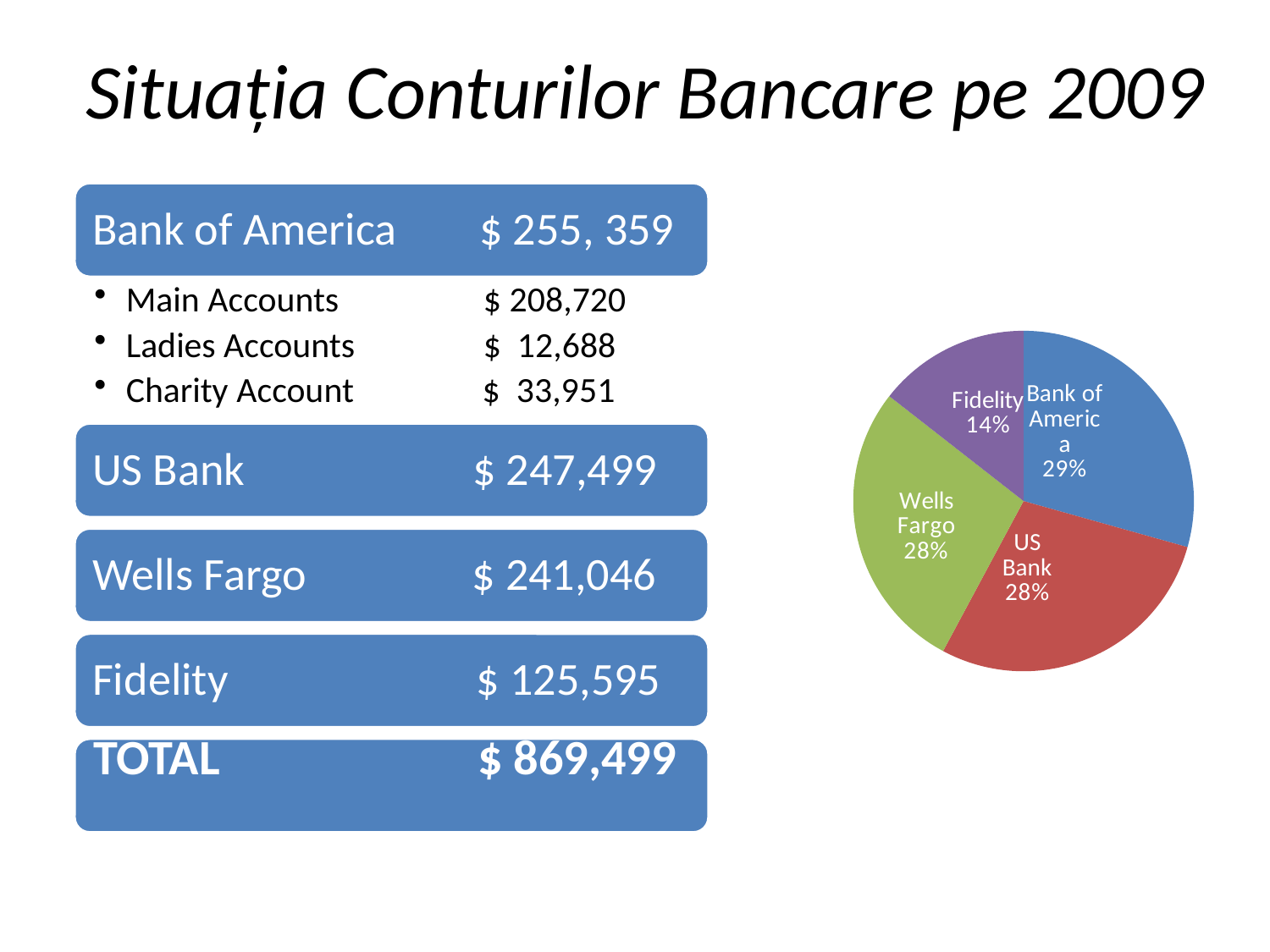
By how many percentage points does the Bank of America share exceed the Fidelity share in the pie chart? 15 Which slice of the pie chart is the largest? Bank of America What share of the pie does Fidelity hold? 14% What colour is the Wells Fargo slice in the pie chart? green Which slice is larger in the pie chart, Bank of America or Fidelity? Bank of America What share of the pie does US Bank hold? 28% How many slices does the pie chart have? 4 Which slice of the pie chart is the smallest? Fidelity What share of the pie does Wells Fargo hold? 28% What colour is the Fidelity slice in the pie chart? purple What kind of chart is shown on the slide? pie chart